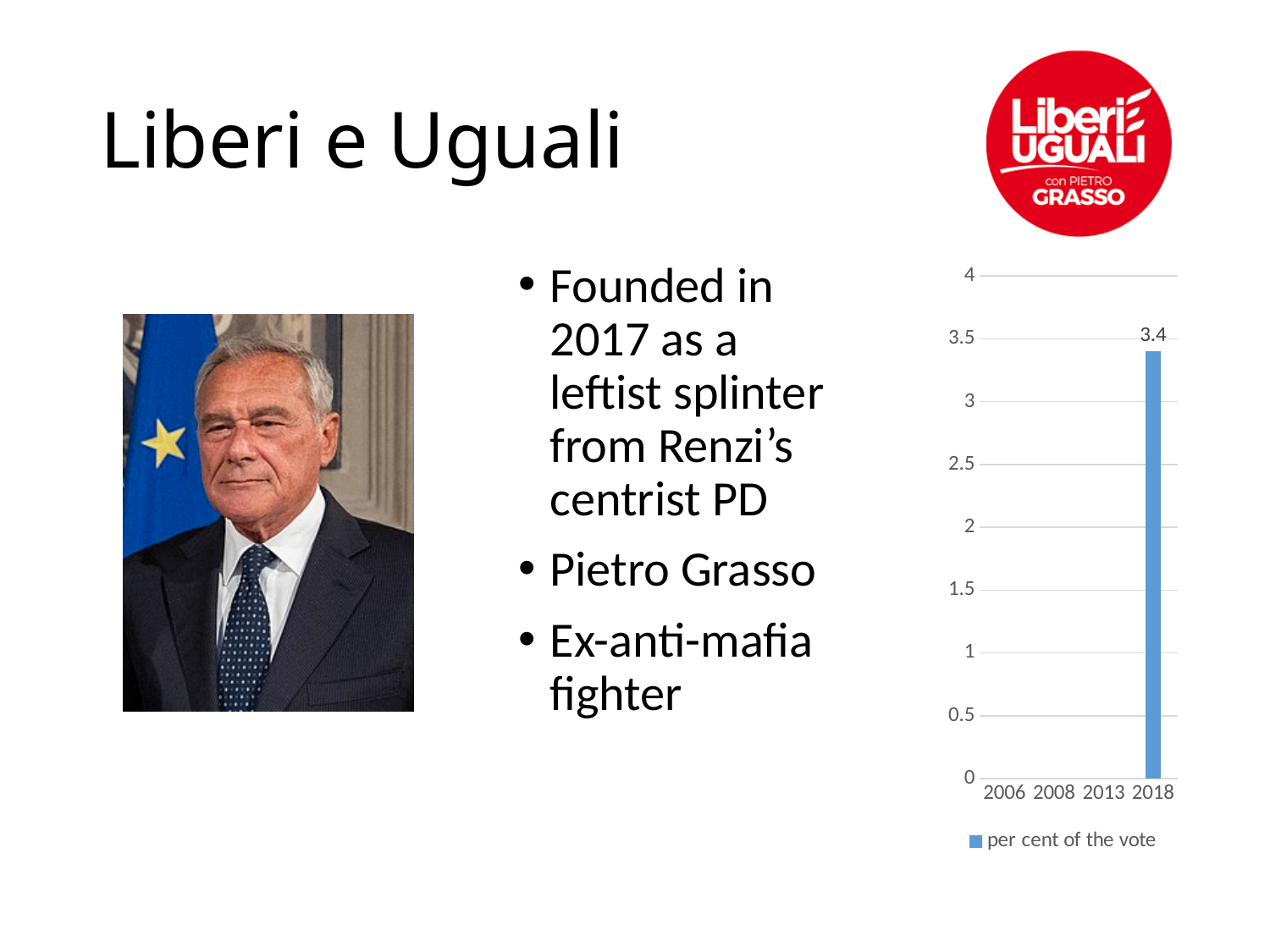
What kind of chart is shown on the slide? bar chart Is the value for 2018 greater or less than 3.5? less What is the series name shown in the chart legend? per cent of the vote How many series does the chart legend list? 1 How many of the years on the x axis have a visible bar? 1 How many years are shown on the x axis of the chart? 4 What is the value for 2018 in the chart? 3.4 Which year has the highest value in the chart? 2018 What is the highest value shown on the chart's y axis? 4 Is the value for 2018 greater or less than 3? greater Which is larger, the value for 2013 or the value for 2018? 2018